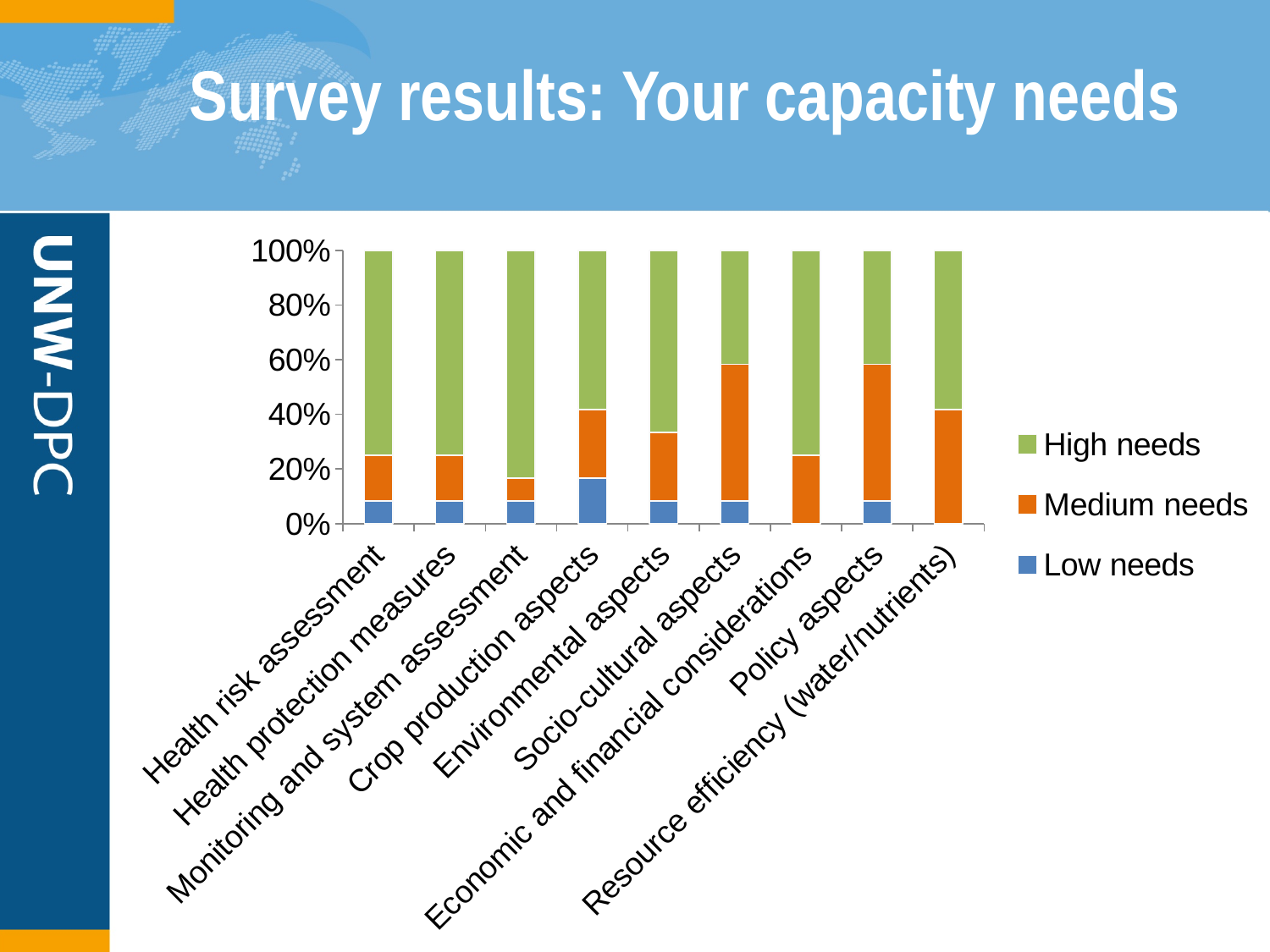
Which category has the largest High needs segment? Monitoring and system assessment Is the High needs value for Socio-cultural aspects greater or less than 60%? less Is the High needs value for Health risk assessment greater or less than 60%? greater Which series is shown in green in the chart's legend? High needs Which category has the largest Low needs segment? Crop production aspects What is the total of the stacked bar for Health risk assessment? 100% Which has the larger High needs segment, Health risk assessment or Policy aspects? Health risk assessment Is the Low needs value for Crop production aspects greater or less than 20%? less What is the title of the slide containing the chart? Survey results: Your capacity needs How many categories are shown along the x axis of the chart? 9 How many series does the chart's legend list? 3 What kind of chart is shown on the slide? bar chart